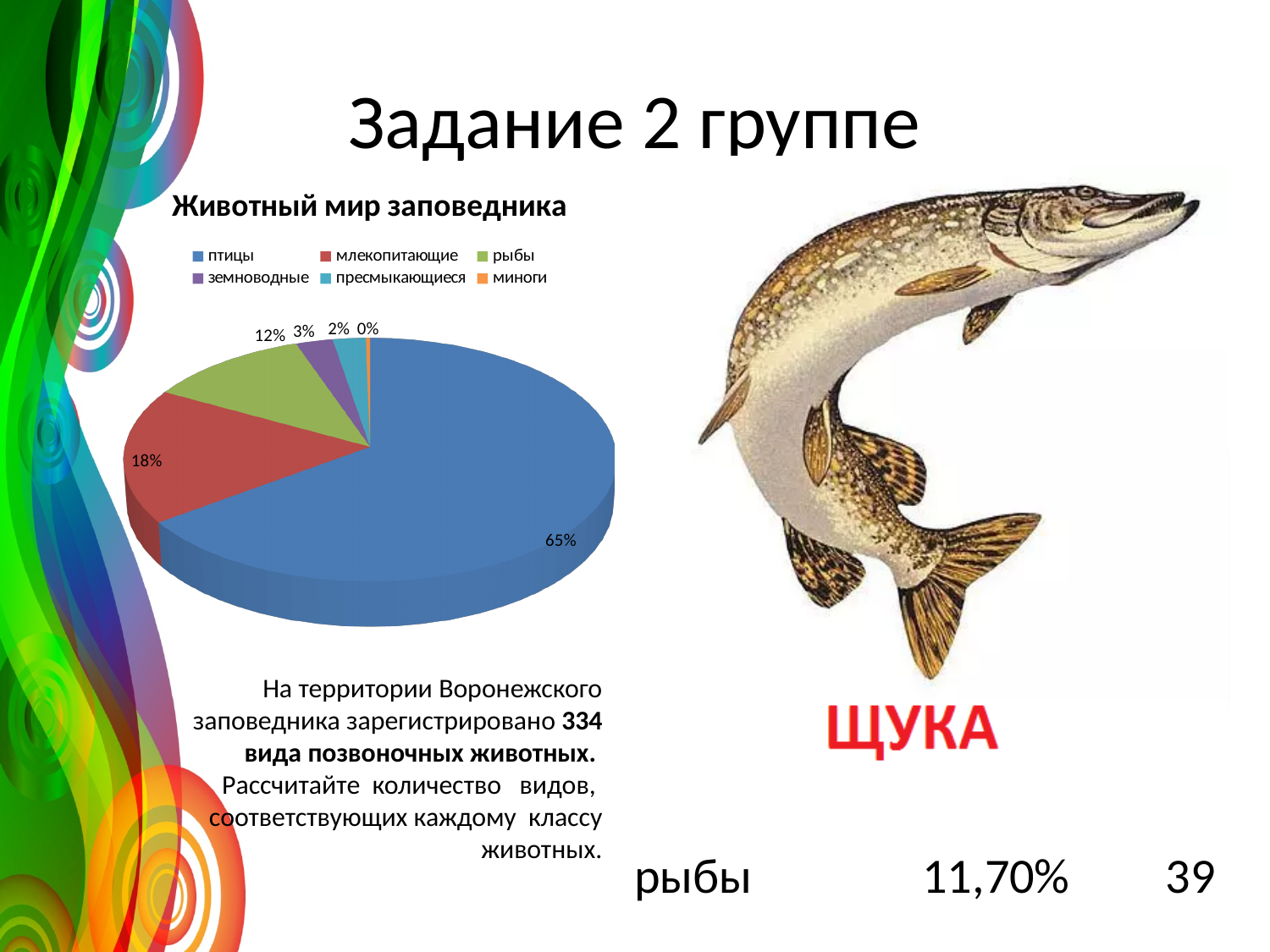
What is the chart's title? Животный мир заповедника What share of the pie does земноводные take? 3% Which is larger, the share for млекопитающие or the share for рыбы? млекопитающие Which category has the largest slice of the pie? птицы Which category has the smallest slice of the pie? миноги What share of the pie does млекопитающие take? 18% What share of the pie does рыбы take? 12% What kind of chart is shown on the slide? pie chart What is the difference in percentage points between the share for птицы and the share for млекопитающие? 47% How many categories does the legend of the pie chart list? 6